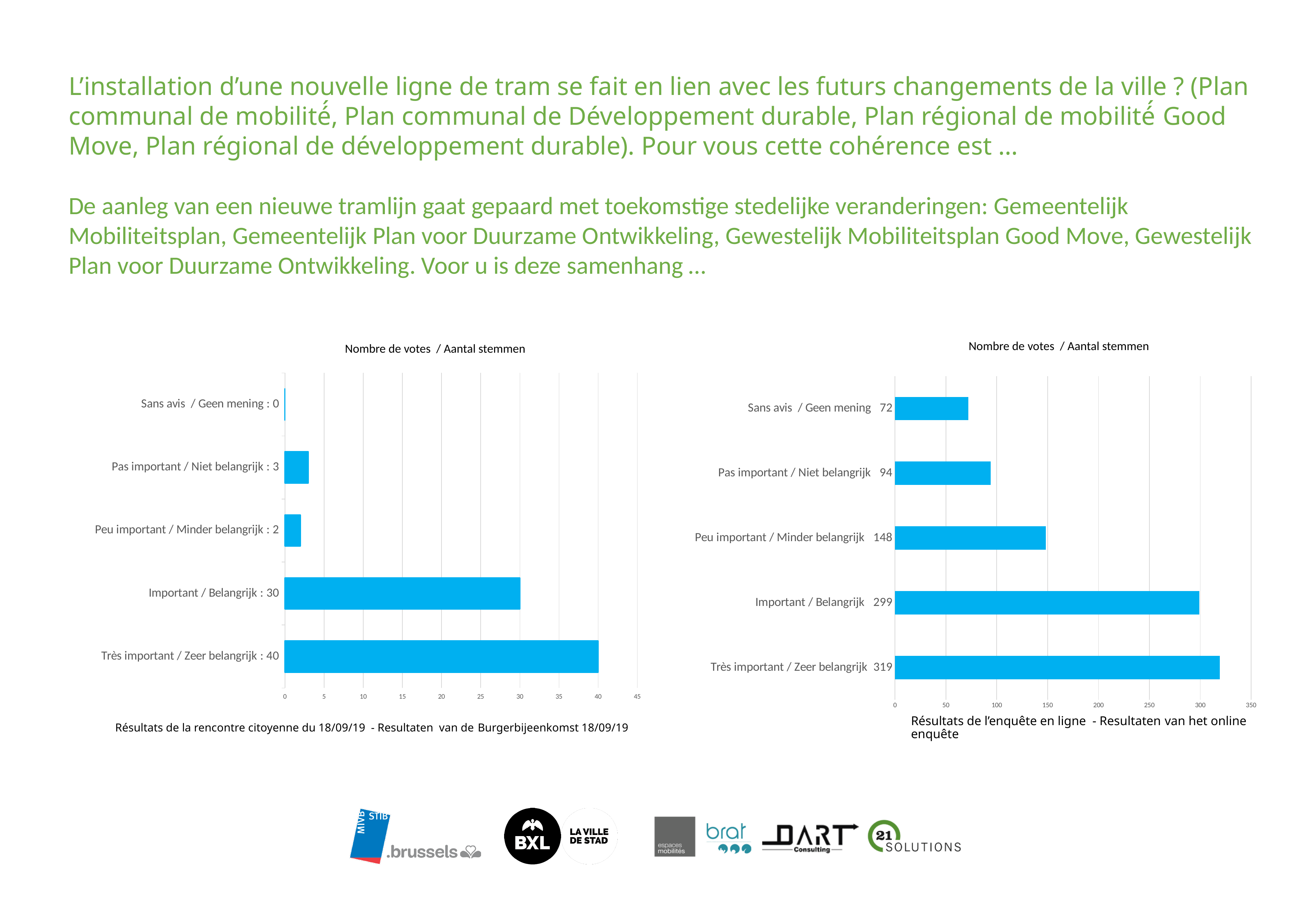
In the left chart (rencontre citoyenne), how many votes did 'Important / Belangrijk' receive? 30 What type of chart is the right chart (enquête en ligne)? Bar chart In the right chart (enquête en ligne), what is the difference in votes between 'Très important / Zeer belangrijk' and 'Important / Belangrijk'? 20 How many categories are shown in the left chart (rencontre citoyenne)? 5 In the right chart (enquête en ligne), how many votes did 'Peu important / Minder belangrijk' receive? 148 What is the total number of votes across all categories in the right chart (enquête en ligne)? 932 In the left chart (Résultats de la rencontre citoyenne du 18/09/19), how many votes did 'Très important / Zeer belangrijk' receive? 40 In the right chart (enquête en ligne), which category has the highest number of votes? Très important / Zeer belangrijk In the left chart (rencontre citoyenne), what is the difference in votes between 'Très important / Zeer belangrijk' and 'Important / Belangrijk'? 10 In the right chart (enquête en ligne), which has more votes: 'Pas important / Niet belangrijk' or 'Peu important / Minder belangrijk'? Peu important / Minder belangrijk In the right chart (Résultats de l'enquête en ligne), how many votes did 'Sans avis / Geen mening' receive? 72 In the left chart (rencontre citoyenne), which category has the lowest number of votes? Sans avis / Geen mening